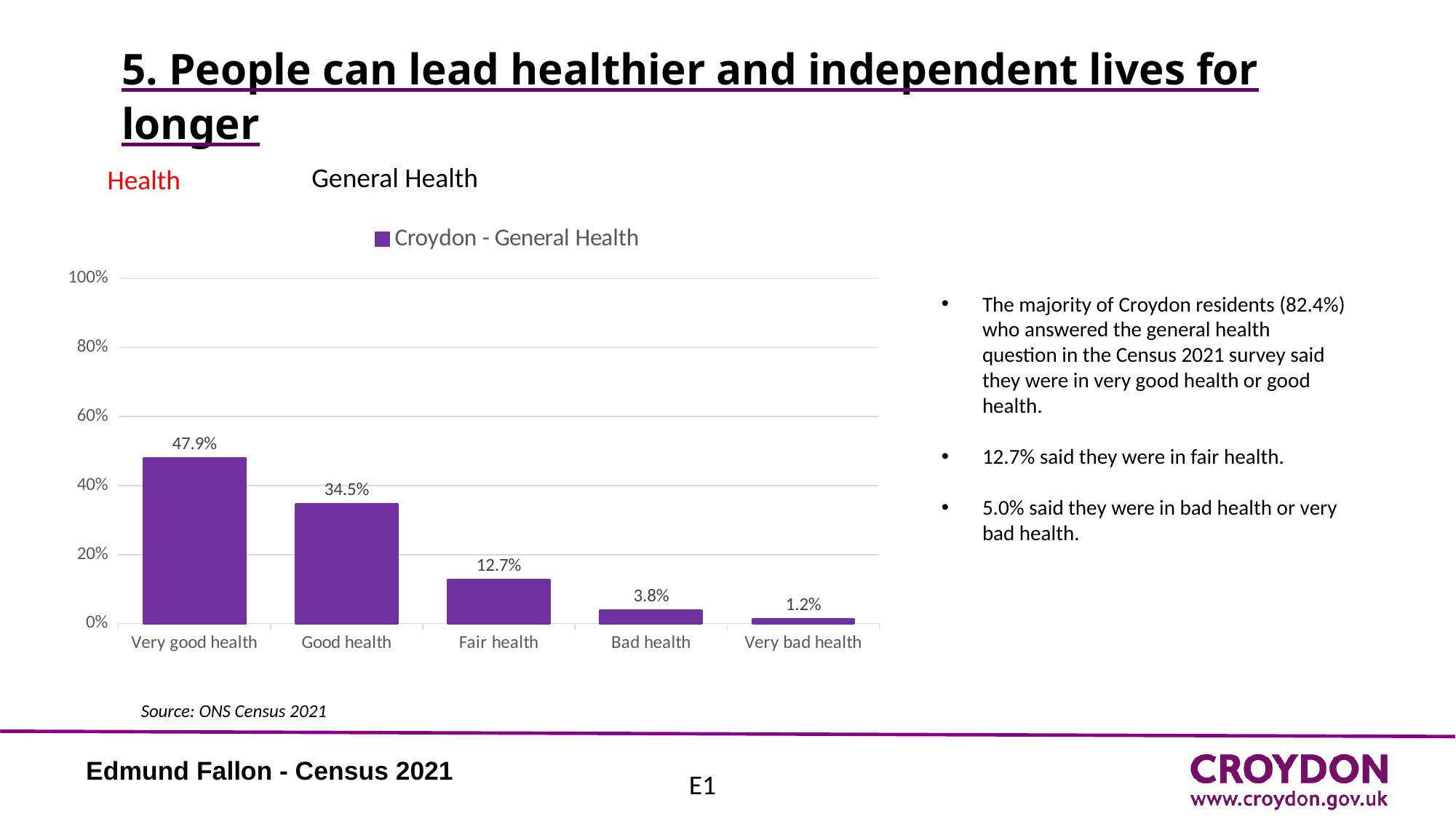
What type of chart is used to show General Health? Bar chart What is the difference between the Very good health and Good health percentages? 13.4% Which health category has the highest percentage? Very good health What is the name of the series shown in the legend? Croydon - General Health What is the value for Very bad health? 1.2% Which health category has the lowest percentage? Very bad health What percentage is shown for Fair health? 12.7% Is the value for Good health greater or less than 40%? less How many health categories are shown on the x axis? 5 Which is larger, the value for Bad health or the value for Very bad health? Bad health What percentage of Croydon residents reported very good health? 47.9% What is the value shown for Good health? 34.5%